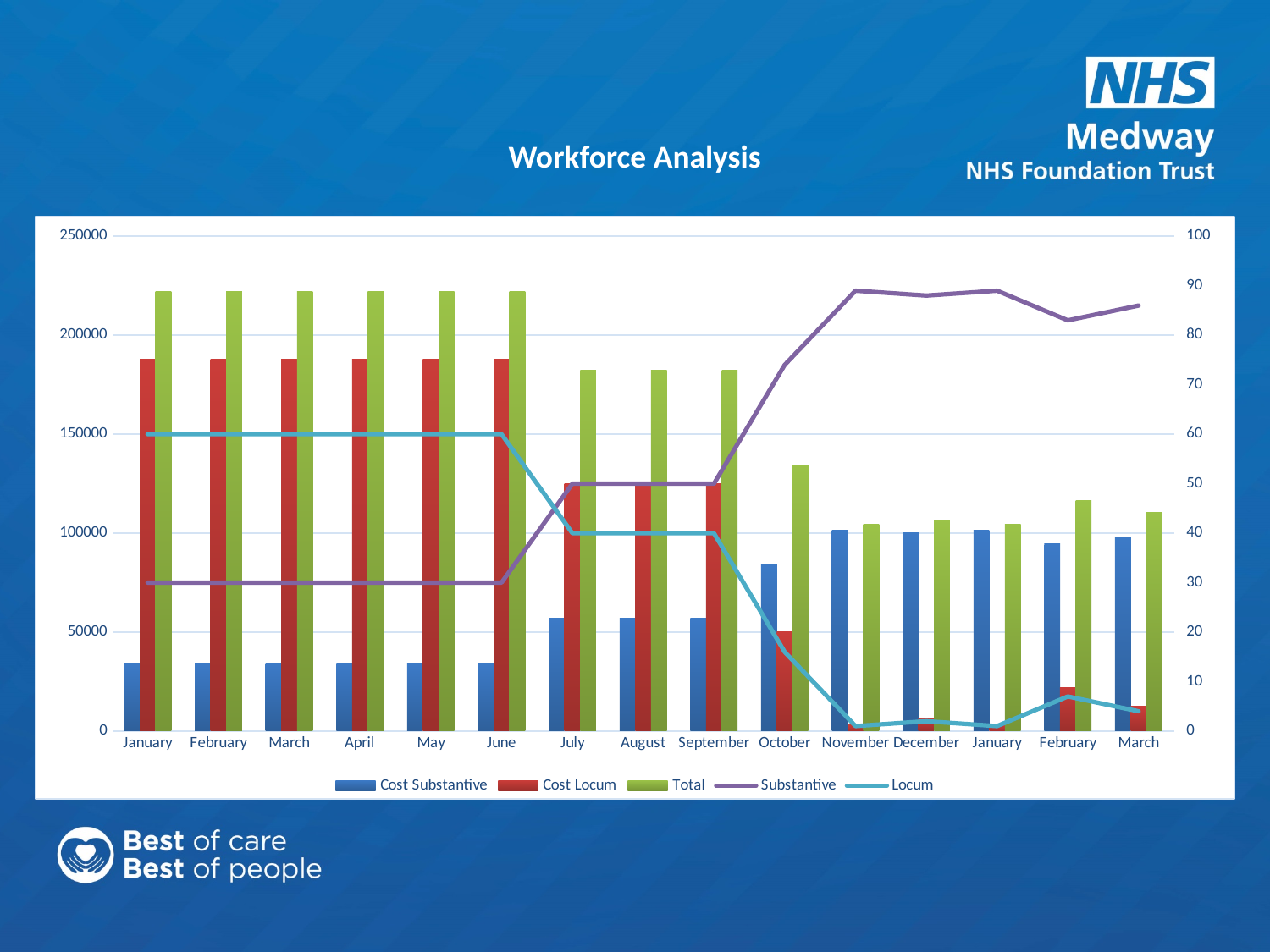
How many months are shown along the x axis? 15 Is the Cost Locum bar for November greater or less than 50000? less What kind of chart is shown on the slide? A combined bar and line chart Which is larger, the Cost Locum bar for the first January or the Cost Locum bar for July? The first January Does the Substantive line rise or fall between June and November? Rises Which is larger, the Total bar for the first January or the Total bar for the final March? The first January Is the Total bar for the first January greater or less than 200000? greater How many series does the legend list? 5 What is the title of the chart? Workforce Analysis Which colour represents the Total series in the legend? Green Is the Substantive line value for November greater or less than 80 on the right axis? greater